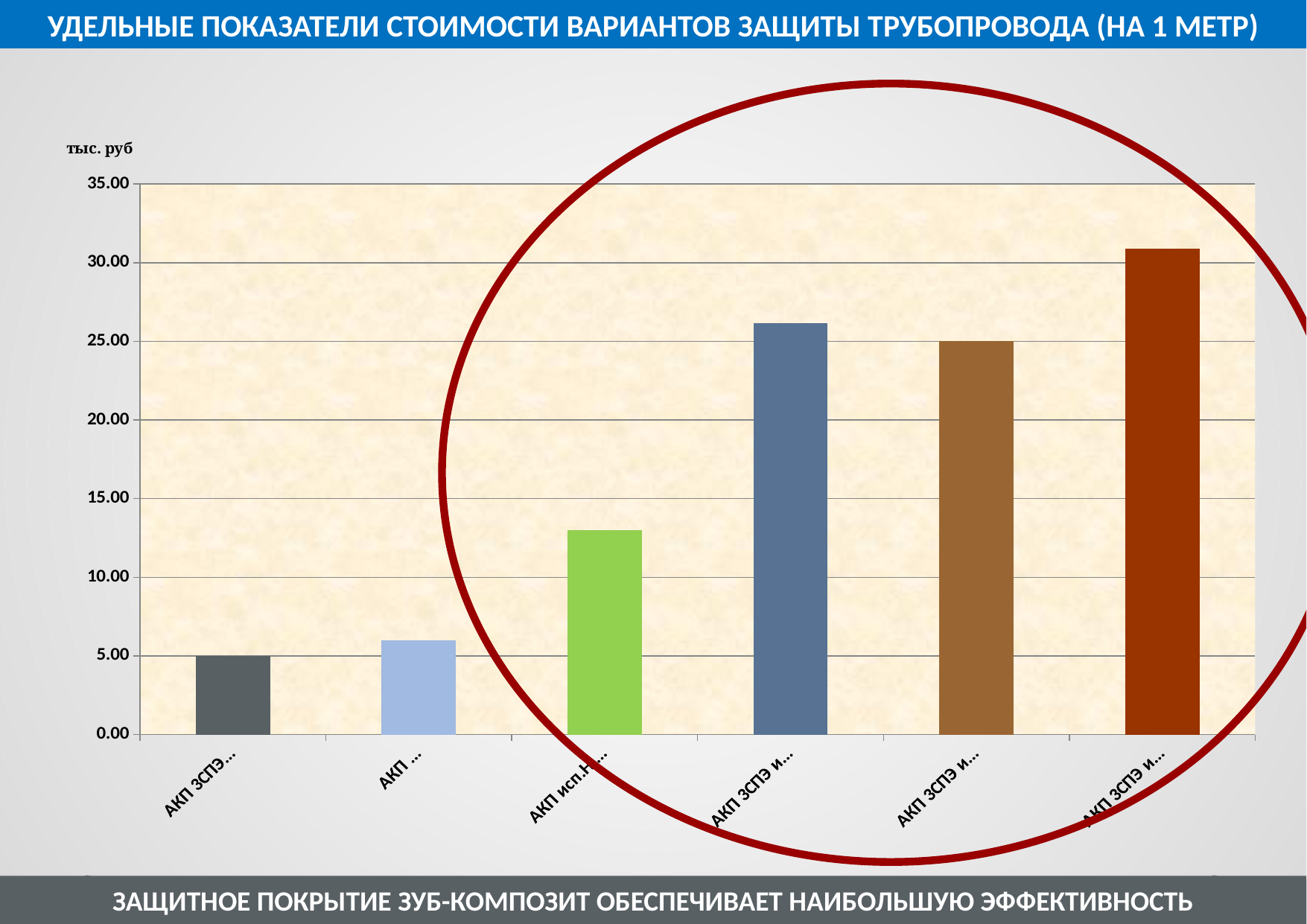
Which bar has the lowest value in the chart? the first (leftmost, dark grey) bar What unit is shown above the y axis of the chart? тыс. руб Which is larger, the value of the third (green) bar or the fourth (blue) bar? the fourth (blue) bar What is the title of the chart on the slide? УДЕЛЬНЫЕ ПОКАЗАТЕЛИ СТОИМОСТИ ВАРИАНТОВ ЗАЩИТЫ ТРУБОПРОВОДА (НА 1 МЕТР) What value does the first (leftmost) bar reach on the y axis? 5.00 Is the value of the third (green) bar greater or less than 10.00? greater What kind of chart is shown on the slide? bar chart Is the value of the sixth (rightmost) bar greater or less than 30.00? greater Which bar has the highest value in the chart? the sixth (rightmost, dark orange) bar Is the value of the second (light blue) bar greater or less than 10.00? less How many bars are plotted in the chart? 6